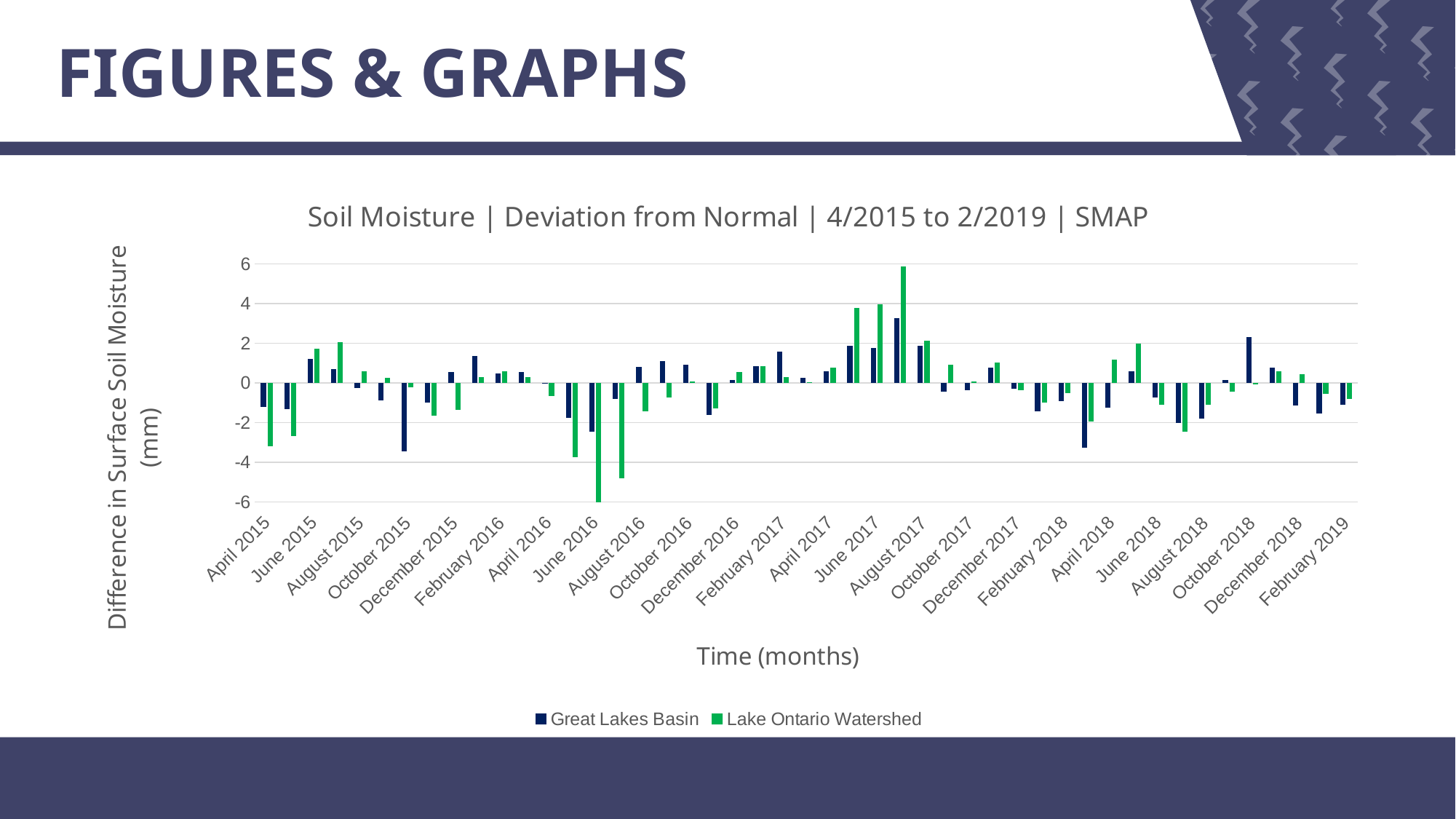
Is the Great Lakes Basin value for October 2015 greater or less than -2? less Is the Lake Ontario Watershed value for April 2015 greater or less than -2? less What kind of chart is shown on the slide? bar chart In October 2015, which series has the larger value, Great Lakes Basin or Lake Ontario Watershed? Lake Ontario Watershed In June 2016, which series has the larger value, Great Lakes Basin or Lake Ontario Watershed? Great Lakes Basin What are the two series named in the legend? Great Lakes Basin and Lake Ontario Watershed Which series has the single highest bar on the chart? Lake Ontario Watershed Is the Great Lakes Basin value for October 2018 greater or less than 1? greater How many series does the legend list? 2 What is the title of the chart? Soil Moisture | Deviation from Normal | 4/2015 to 2/2019 | SMAP